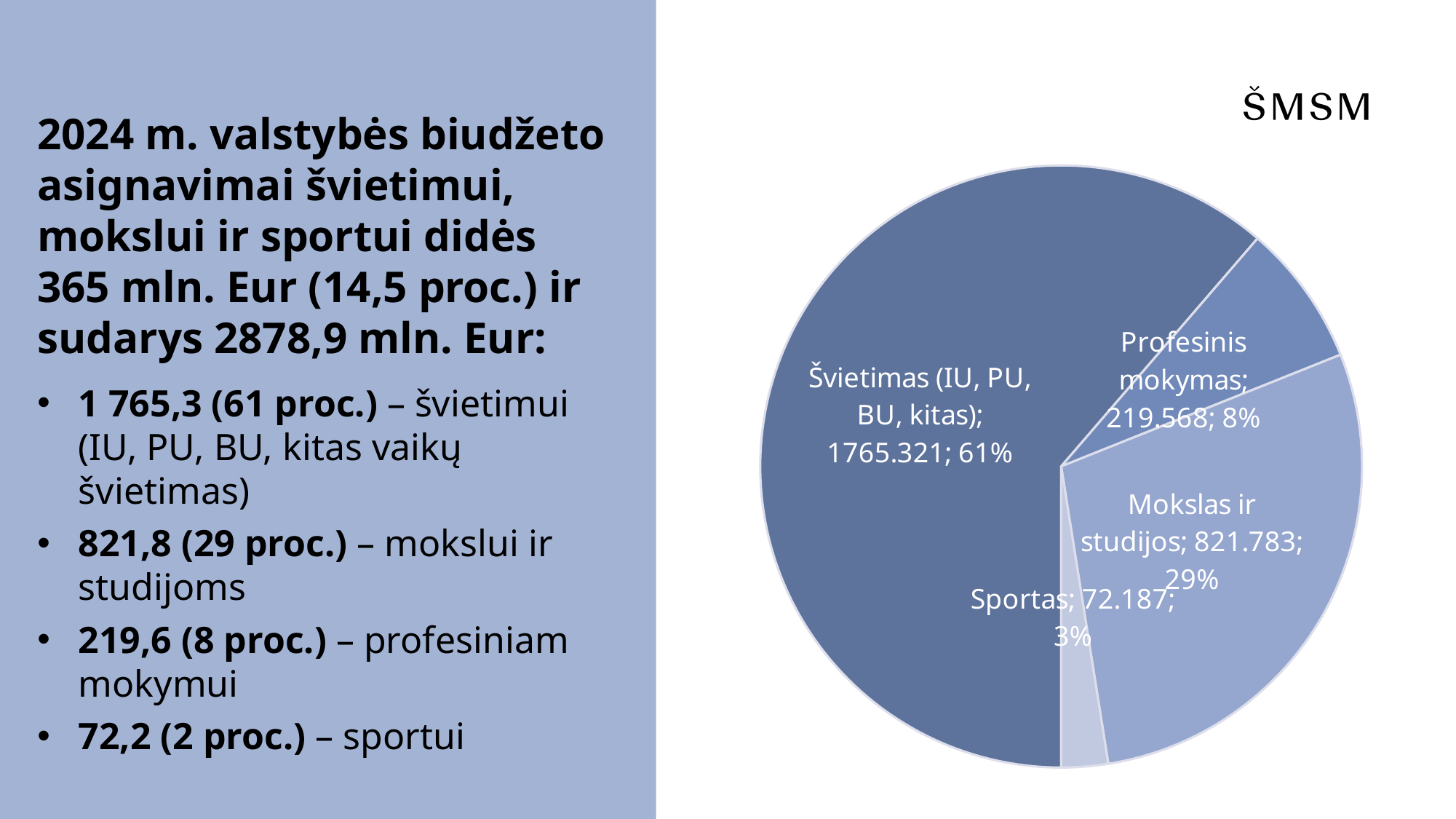
What is the value shown for the Profesinis mokymas slice? 219.568 What is the value shown for the Mokslas ir studijos slice? 821.783 What type of chart is shown on the slide? pie chart Which is larger, the Profesinis mokymas slice or the Mokslas ir studijos slice? Mokslas ir studijos What is the difference between the values for Profesinis mokymas and Sportas? 147.381 What is the value shown for the Sportas slice? 72.187 Which slice of the pie chart is the largest? Švietimas (IU, PU, BU, kitas) What percentage share does the Mokslas ir studijos slice have? 29% How many slices does the pie chart have? 4 What is the difference between the values for Mokslas ir studijos and Profesinis mokymas? 602.215 Which slice of the pie chart is the smallest? Sportas What percentage share does the Švietimas (IU, PU, BU, kitas) slice have? 61%